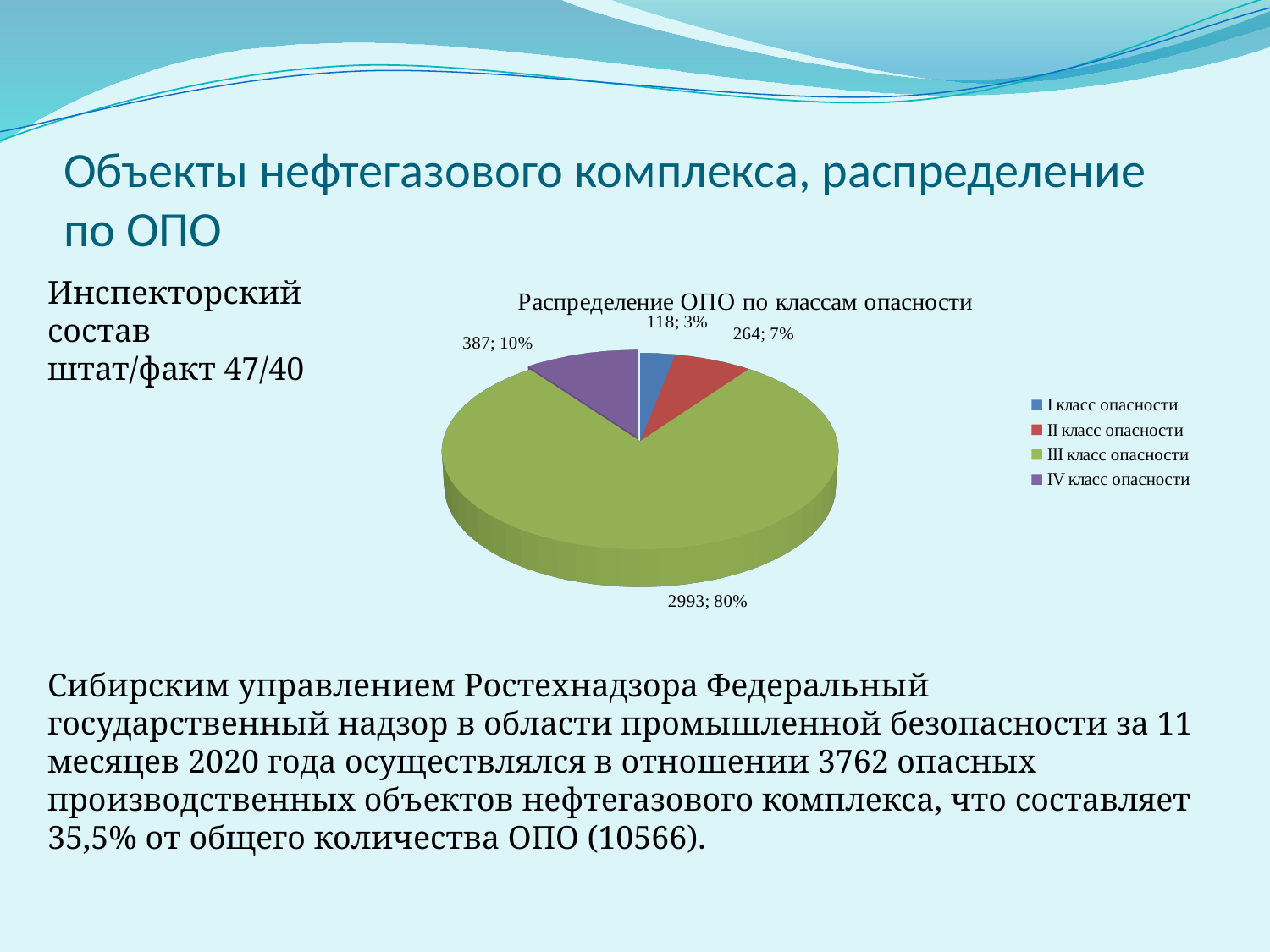
How many categories does the legend of the pie chart list? 4 What is the title of the chart? Распределение ОПО по классам опасности What share of the pie does II класс опасности represent? 7% Which class has the smallest slice of the pie? I класс опасности Which class has the largest slice of the pie? III класс опасности What is the value for IV класс опасности? 387 What type of chart is shown on the slide? pie chart Which is larger, the value for II класс опасности or the value for IV класс опасности? IV класс опасности What share of the pie does III класс опасности represent? 80% What is the value for I класс опасности? 118 What is the difference between the values for IV класс опасности and II класс опасности? 123 What is the value for III класс опасности? 2993